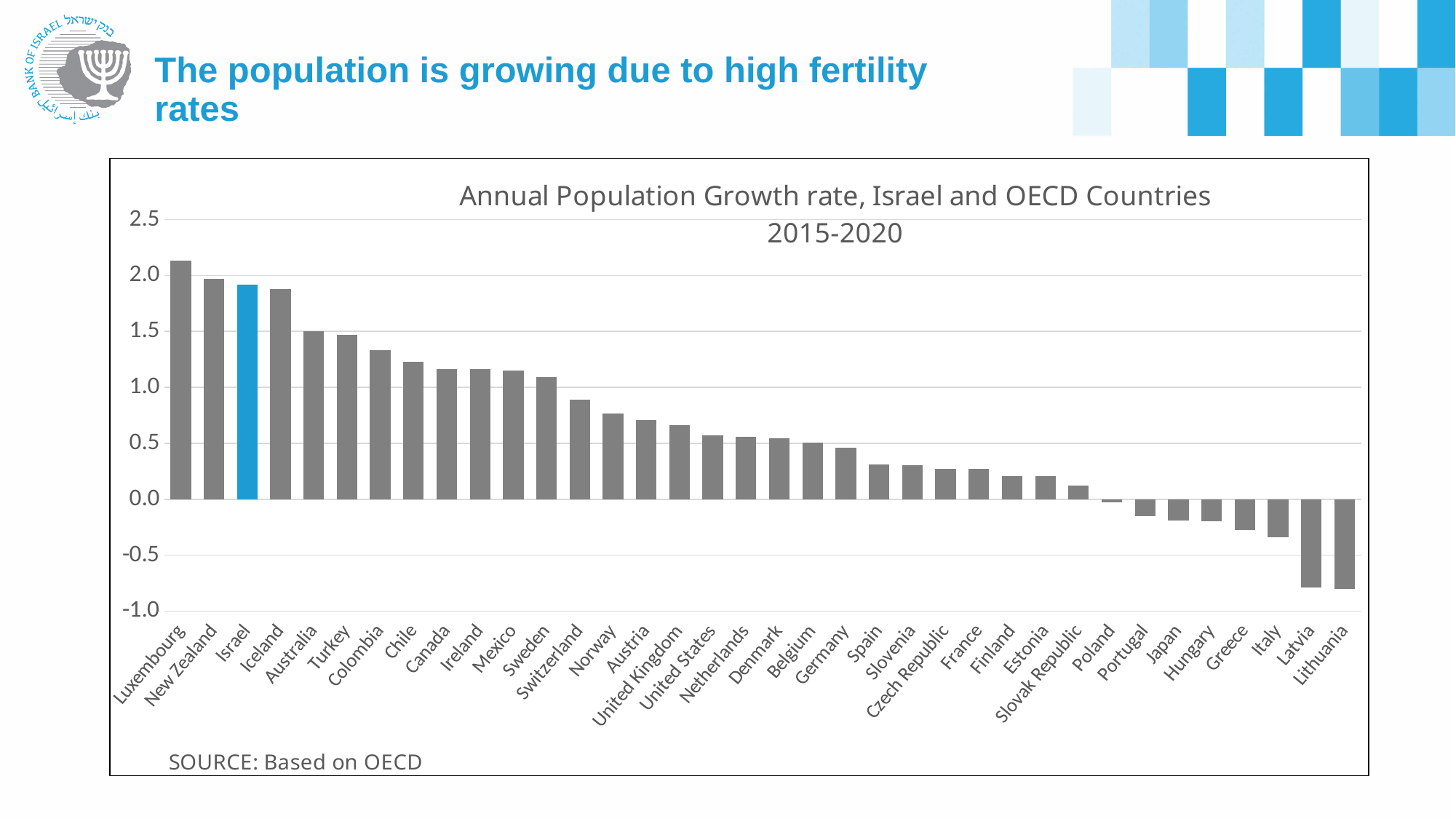
What is the title of the chart? Annual Population Growth rate, Israel and OECD Countries 2015-2020 Which country is highlighted with a blue bar in the chart? Israel Is the value for Switzerland greater or less than 1.0? less Do the values rise or fall moving from left to right along the x axis? Fall Is the value for Latvia greater or less than -0.5? less Is the value for Japan greater or less than 0.0? less What type of chart is shown on the slide? Bar chart How many countries are shown in the chart? 36 Which has a higher annual population growth rate, Israel or Australia? Israel Which country has the highest annual population growth rate in the chart? Luxembourg